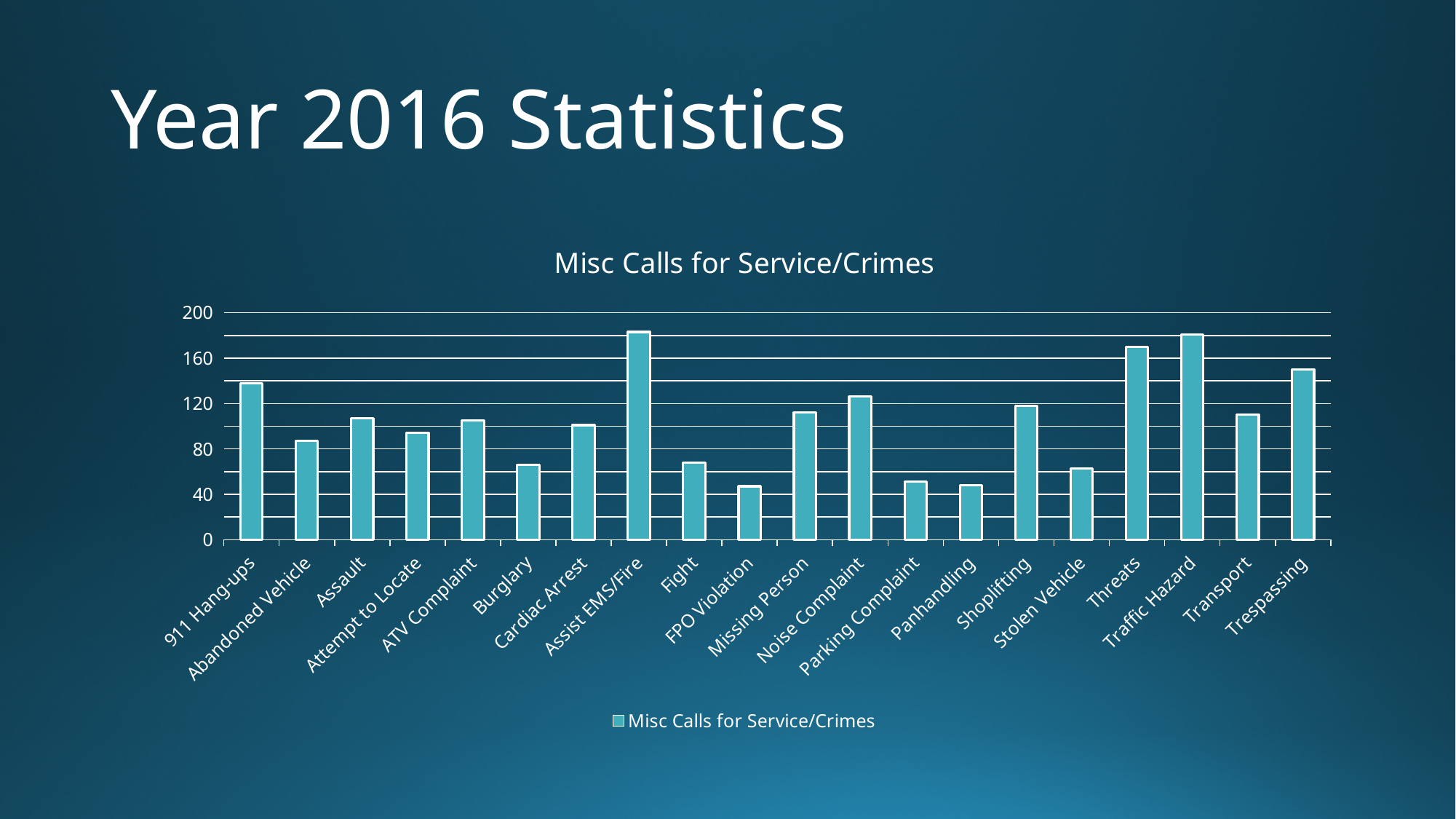
What kind of chart is shown on the slide? bar chart How many series does the legend list? 1 Is the value for Trespassing greater or less than 120? greater How many categories are shown on the x axis of the chart? 20 Which is larger, the value for Threats or the value for Burglary? Threats What is the title of the chart? Misc Calls for Service/Crimes What is the highest value shown on the vertical axis? 200 Is the value for Burglary greater or less than 80? less Is the value for FPO Violation greater or less than 80? less Which is larger, the value for Noise Complaint or the value for Fight? Noise Complaint